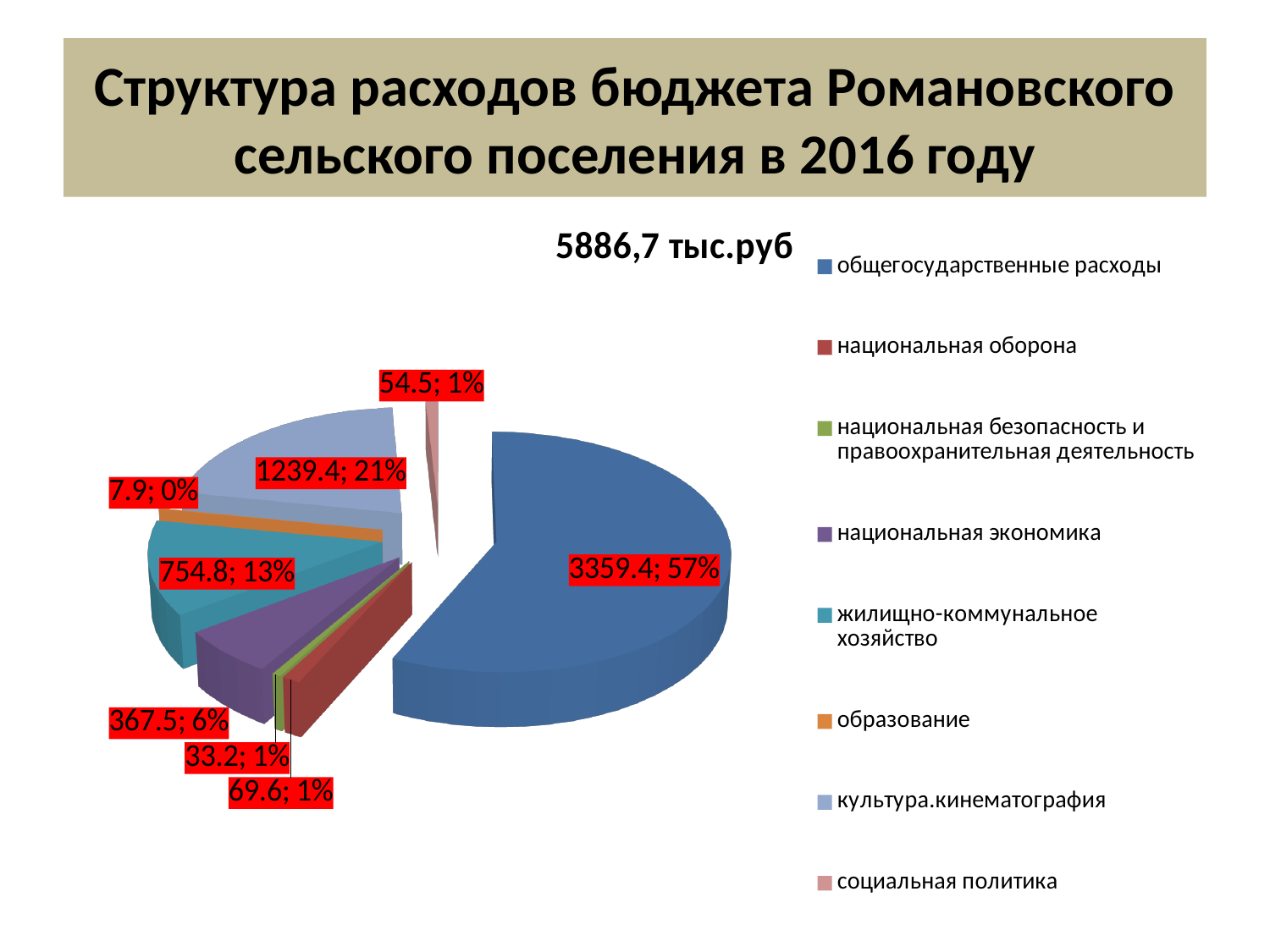
Which category has the largest slice of the pie? общегосударственные расходы What is the value shown for национальная экономика? 367.5; 6% Which category has the smallest slice of the pie? образование Which is larger, the value for национальная оборона or the value for национальная безопасность и правоохранительная деятельность? национальная оборона How many categories does the legend list? 8 What is the value shown for культура.кинематография? 1239.4; 21% What share of the pie does социальная политика represent? 1% What is the value shown for образование? 7.9; 0% What is the value shown for жилищно-коммунальное хозяйство? 754.8; 13% What is the value shown for общегосударственные расходы? 3359.4; 57% What kind of chart is shown on the slide? pie chart What is the title of the chart? 5886,7 тыс.руб